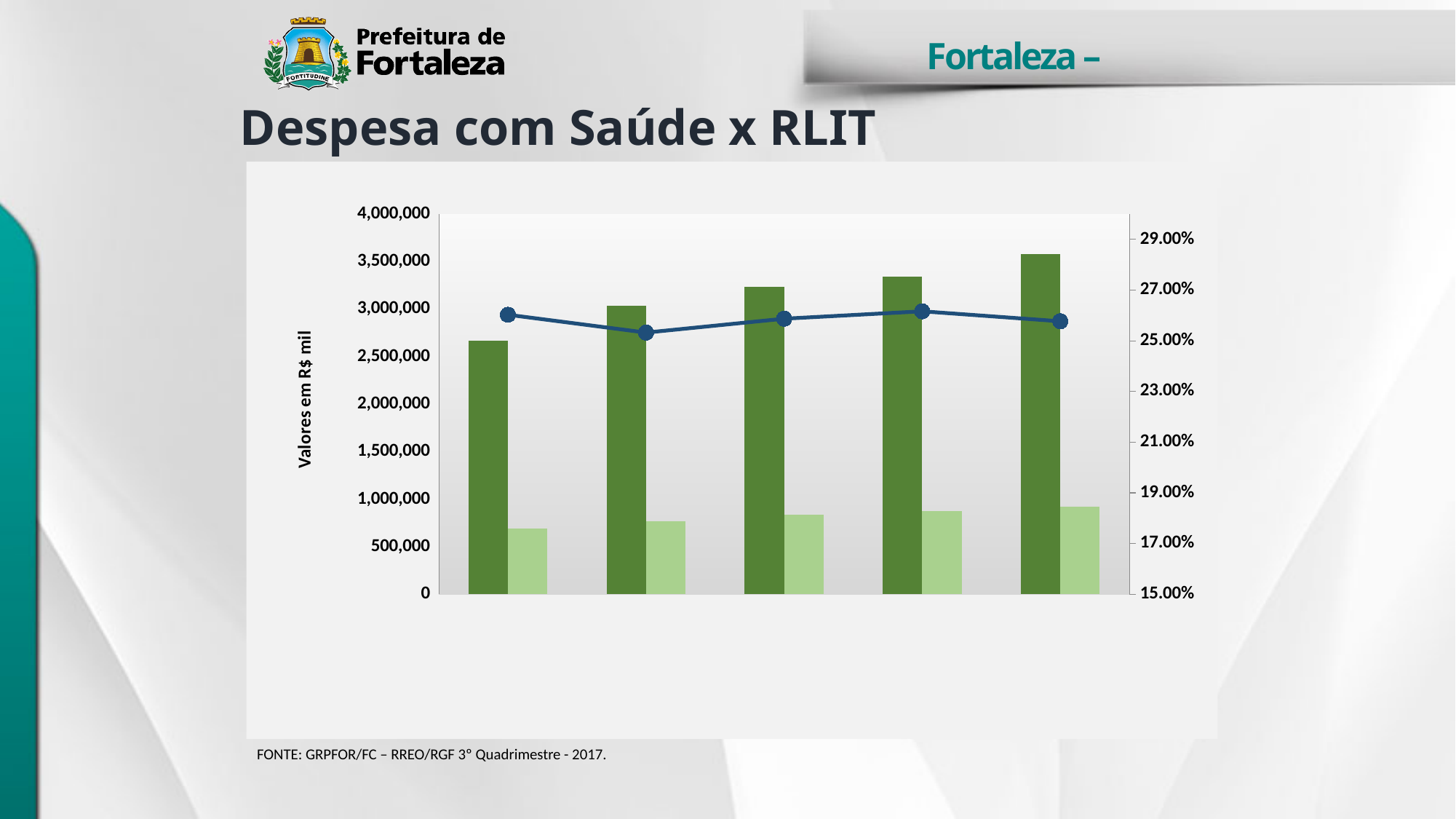
Do the light green bars rise or fall from left to right? Rise Is the first point of the line greater or less than 25.00% on the right axis? greater Do the dark green bars rise or fall from left to right? Rise Which group of bars has the shortest dark green bar? The leftmost (first) group Is the dark green bar in the rightmost group greater or less than 3,500,000? greater Which group of bars has the tallest dark green bar? The rightmost (fifth) group Is the dark green bar in the leftmost group greater or less than 3,000,000? less What is the title of the chart on the slide? Despesa com Saúde x RLIT What is the label of the left vertical axis? Valores em R$ mil What kind of chart is shown on the slide? Combined bar and line chart How many groups of bars are plotted in the chart? 5